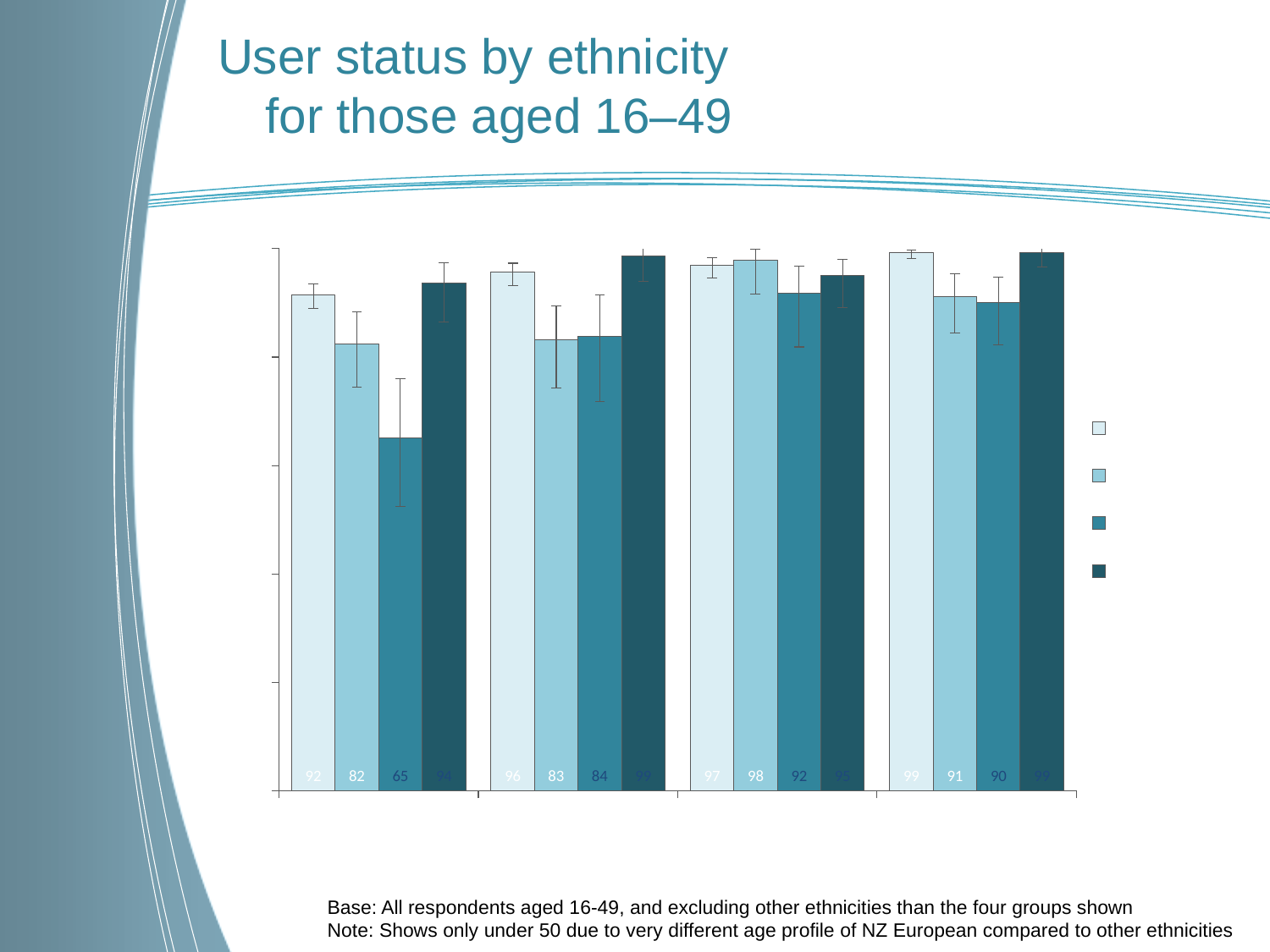
What kind of chart is shown on the slide? bar chart What is the value of the third bar in the first (leftmost) group? 65 In the fourth (rightmost) group, what is the difference between the first bar (99) and the second bar (91)? 8 What is the value of the lightest bar in the first (leftmost) group? 92 In the second group from the left, which is larger: the first bar or the second bar? the first bar In the first (leftmost) group, what is the difference between the first bar (92) and the second bar (82)? 10 How many groups of bars does the chart show? 4 What is the title of the chart slide? User status by ethnicity for those aged 16–49 What is the lowest labelled value on the chart? 65 How many series does the legend list? 4 Do the values of the lightest bars rise or fall from the leftmost group to the rightmost group? rise What is the value of the third bar in the fourth (rightmost) group? 90